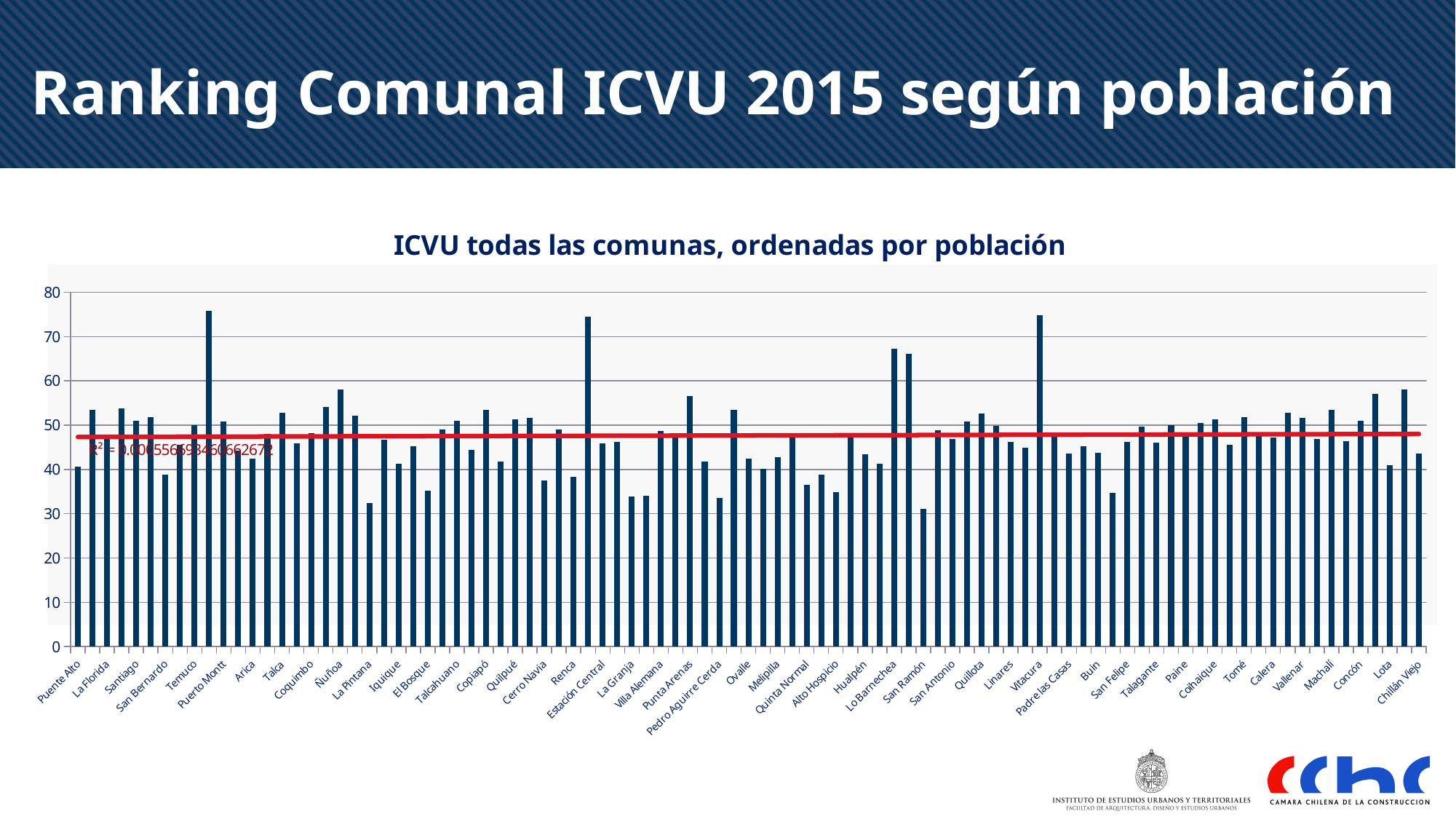
What colour is the trend line drawn across the bars? red Is the value for San Ramón greater or less than 40? less What kind of chart is shown on the slide? bar chart Is the value for Pedro Aguirre Cerda greater or less than 40? less Is the value for Ñuñoa greater or less than 50? greater Does the red trend line rise, fall, or stay roughly flat across the communes from left to right? roughly flat Which has the higher value, Punta Arenas or Cerro Navia? Punta Arenas What is the title of the chart? ICVU todas las comunas, ordenadas por población Which has the higher value, Vitacura or Lo Barnechea? Vitacura